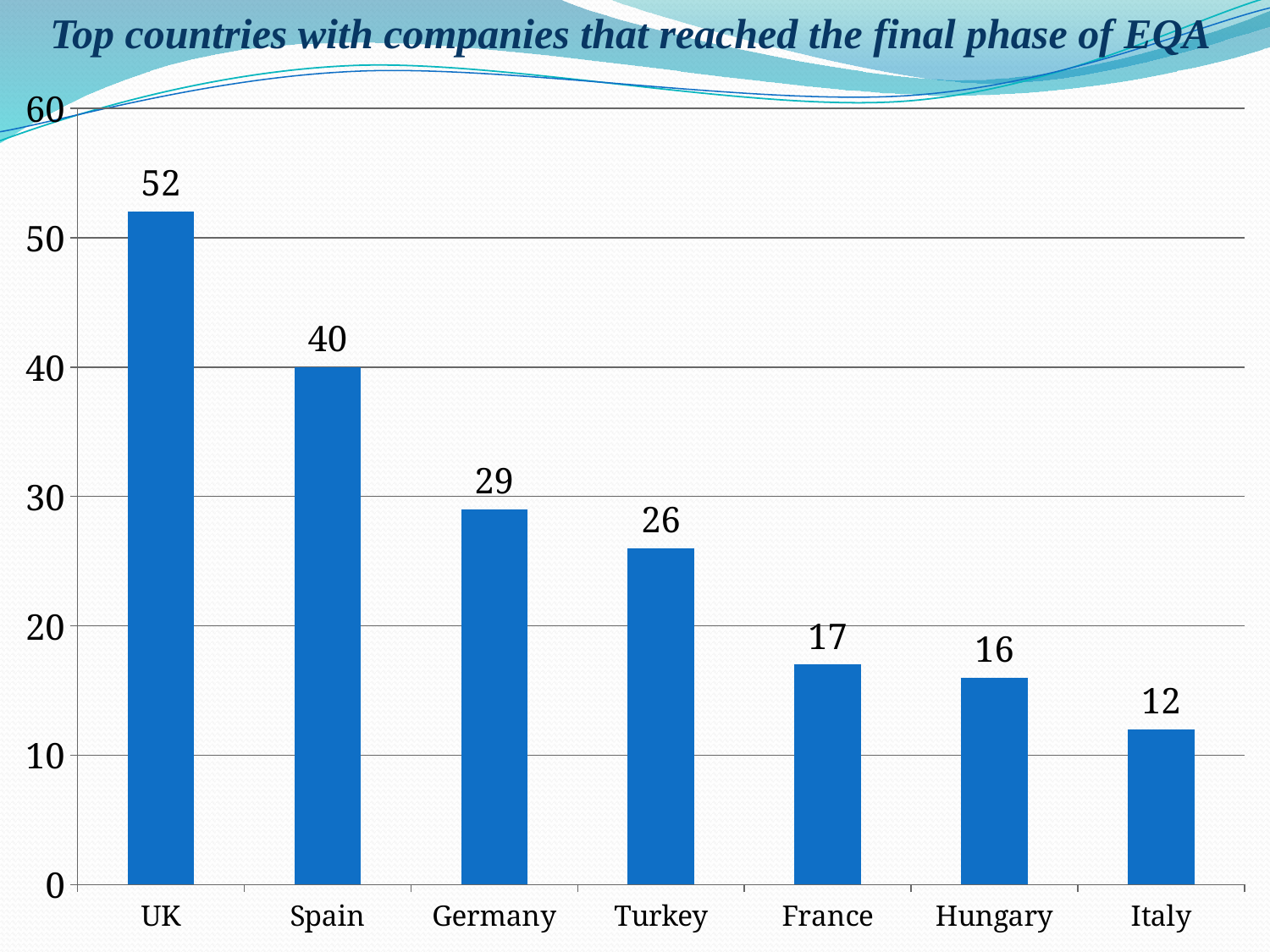
Is the value for Spain greater or less than 30? greater What is the value for Hungary? 16 How many countries are shown on the chart? 7 What is the difference between the values for Turkey and France? 9 Do the values rise or fall from left to right across the countries? fall What is the difference between the values for the UK and Spain? 12 What kind of chart is shown on the slide? bar chart Which country has the lowest value? Italy What is the value for the UK? 52 Which is larger, the value for Germany or the value for Turkey? Germany Which country has the highest value? UK What is the value for Germany? 29